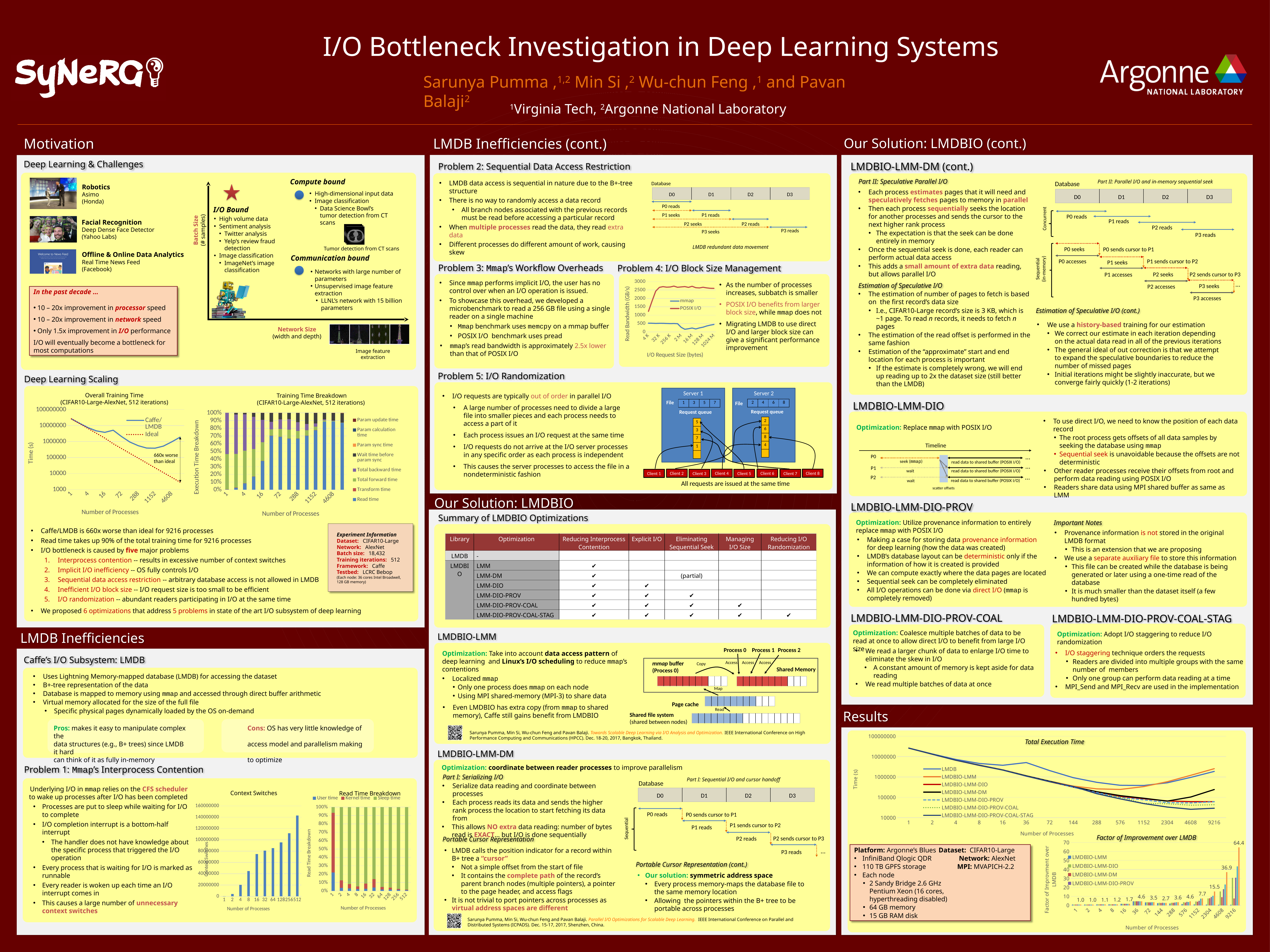
In the 'Overall Training Time' chart, which series has the higher value at 4608 processes, Caffe/LMDB or Ideal? Caffe/LMDB What kind of chart is the 'Total Execution Time' chart in the Results section? line chart In the 'Context Switches' chart, how many process counts are shown on the x axis? 10 In the 'Context Switches' chart, do the values rise or fall as the number of processes increases? rise In the 'Factor of Improvement over LMDB' chart, what is the highest labeled value? 64.4 What kind of chart is the 'Context Switches' chart? bar chart In the Problem 4 read bandwidth chart, is the mmap value at 1024 M greater or less than 1000? less In the 'Training Time Breakdown' chart, how many series does the legend list? 8 In the 'Total Execution Time' chart in the Results section, how many series does the legend list? 7 In the 'Overall Training Time' chart, how many series does the legend list? 2 In the Problem 4 read bandwidth chart, which series has the higher bandwidth at 1024 M request size, mmap or POSIX I/O? POSIX I/O